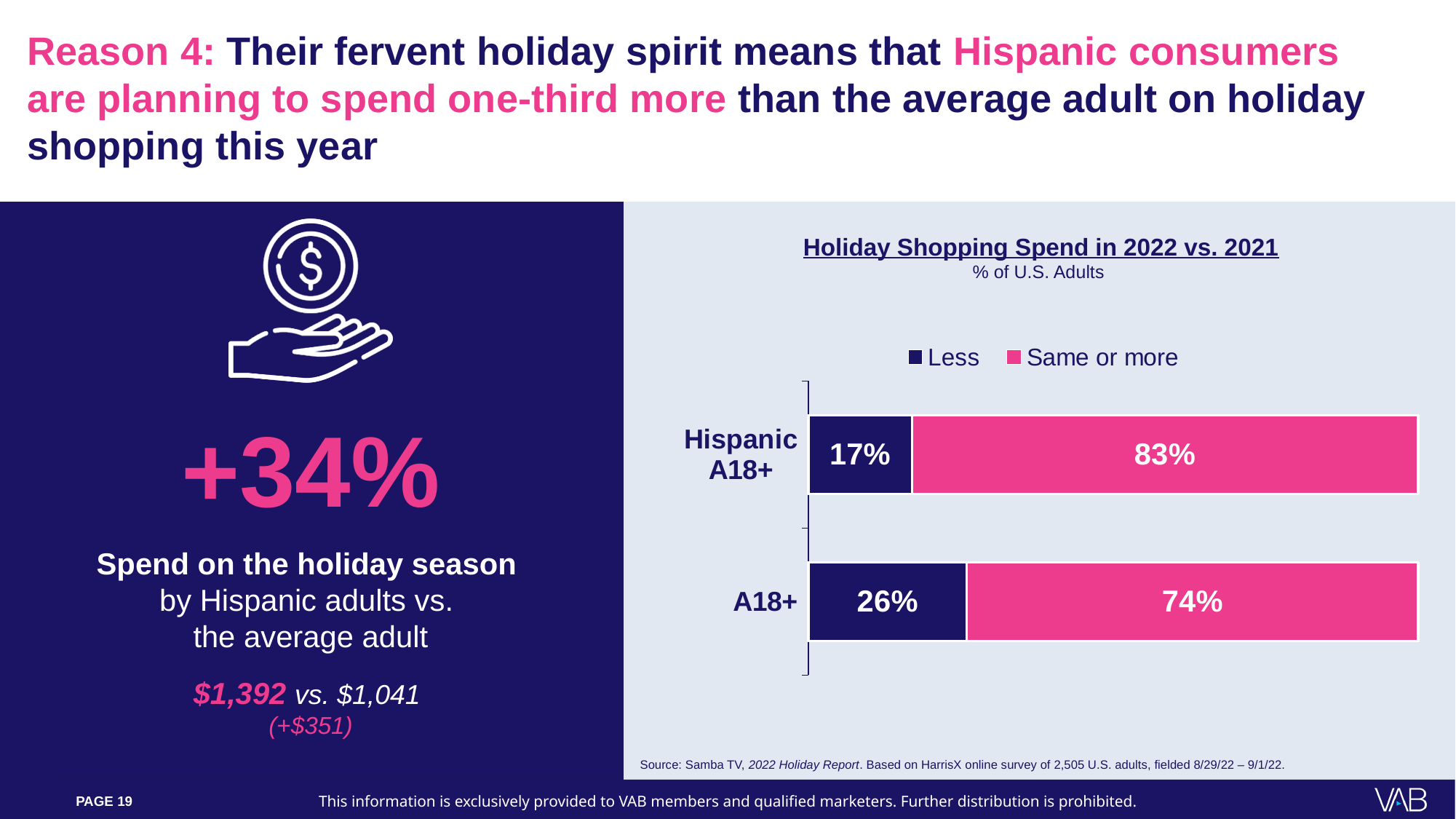
Which category has the higher 'Same or more' value? Hispanic A18+ How many series does the chart's legend list? 2 What kind of chart is shown on the slide? Stacked bar chart What percentage of A18+ plan to spend the same or more? 74% What percentage of A18+ plan to spend less? 26% What is the difference between the 'Same or more' values for Hispanic A18+ and A18+? 9% What are the two series named in the chart's legend? Less; Same or more How many categories are shown on the chart? 2 What is the title of the chart on the slide? Holiday Shopping Spend in 2022 vs. 2021 What percentage of Hispanic A18+ plan to spend less? 17% What percentage of Hispanic A18+ plan to spend the same or more? 83% What is the total of the stacked bar for A18+? 100%